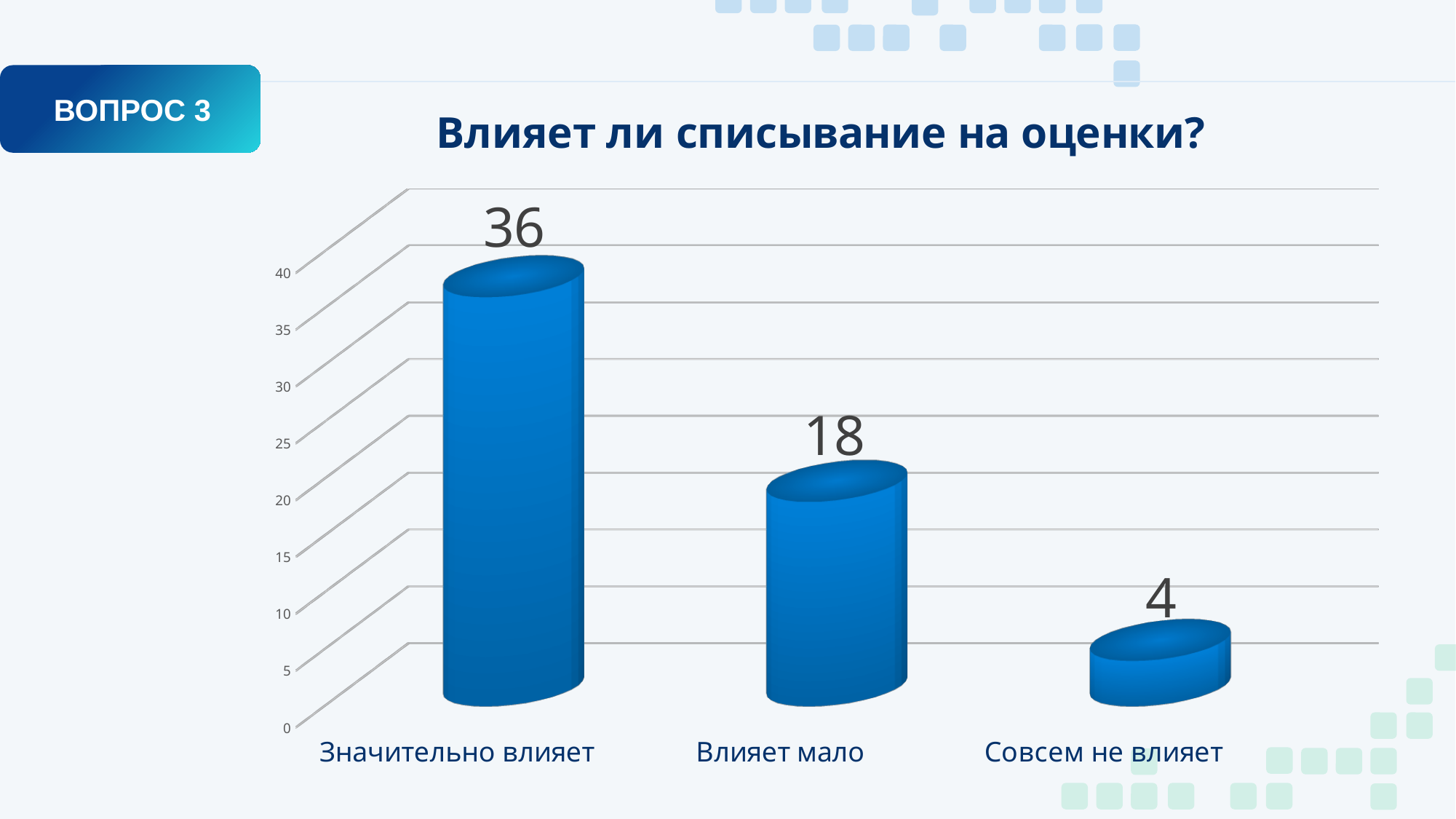
What is the value for "Влияет мало"? 18 What is the title of the chart? Влияет ли списывание на оценки? What kind of chart is shown on the slide? bar chart What is the difference between the values for "Значительно влияет" and "Влияет мало"? 18 Which category has the lowest value? Совсем не влияет Which category has the highest value? Значительно влияет How many categories are shown on the chart? 3 What is the value for "Совсем не влияет"? 4 What is the difference between the values for "Влияет мало" and "Совсем не влияет"? 14 What is the value for "Значительно влияет"? 36 Which is larger, the value for "Влияет мало" or the value for "Совсем не влияет"? Влияет мало Is the value for "Значительно влияет" greater or less than 30? greater